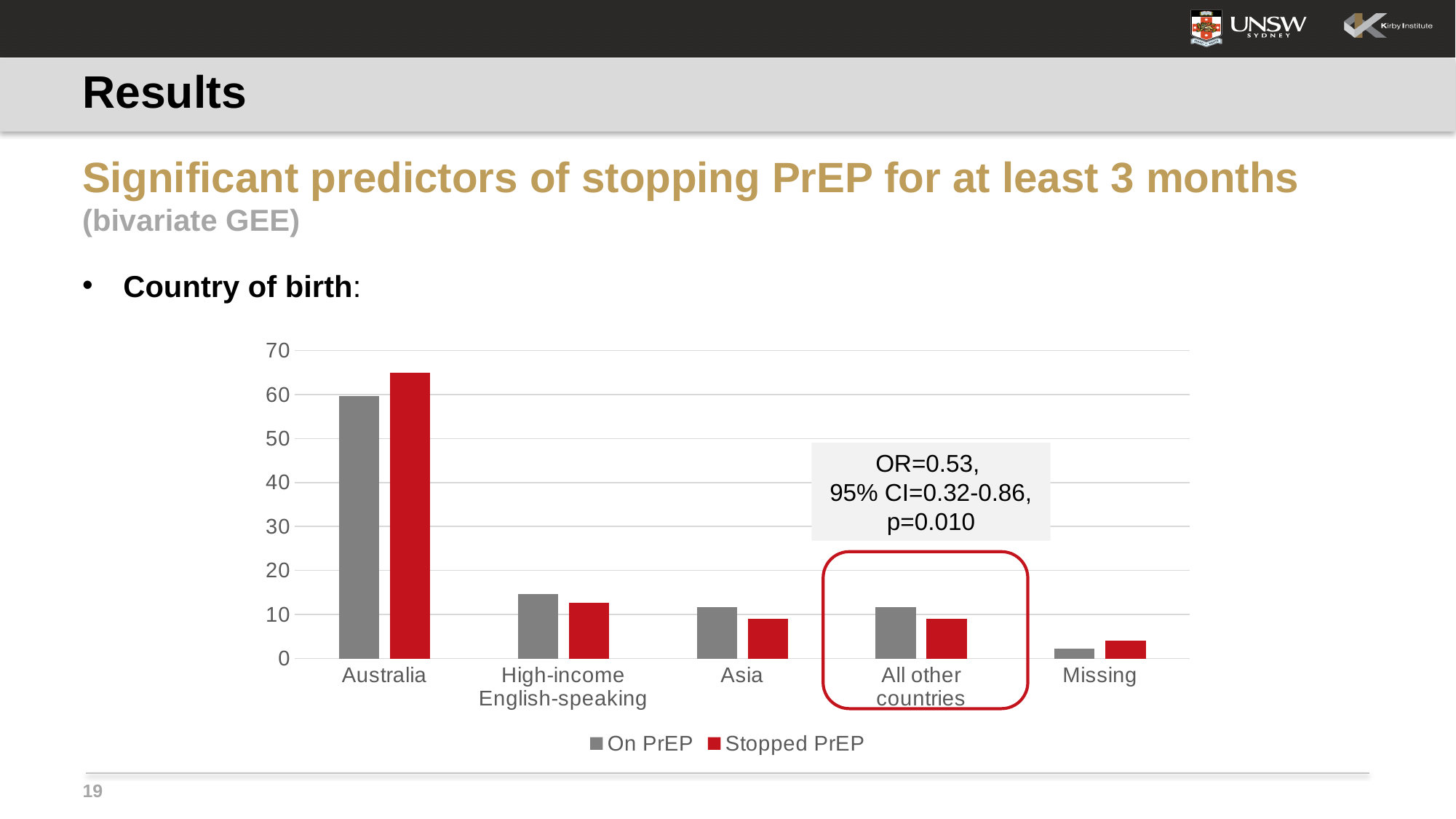
How many country-of-birth categories are shown on the x axis? 5 Is the Stopped PrEP value for Missing greater or less than 10? less What kind of chart is shown on the slide? Bar chart For High-income English-speaking, which is larger: On PrEP or Stopped PrEP? On PrEP Which category has the lowest value for the On PrEP series? Missing What odds ratio is shown in the annotation box above the All other countries bars? OR=0.53 For Australia, which is larger: On PrEP or Stopped PrEP? Stopped PrEP What are the two legend entries of the chart? On PrEP, Stopped PrEP How many series does the legend list? 2 Is the Stopped PrEP value for Australia greater or less than 60? greater Which category has the highest value for the Stopped PrEP series? Australia Is the On PrEP value for High-income English-speaking greater or less than 10? greater